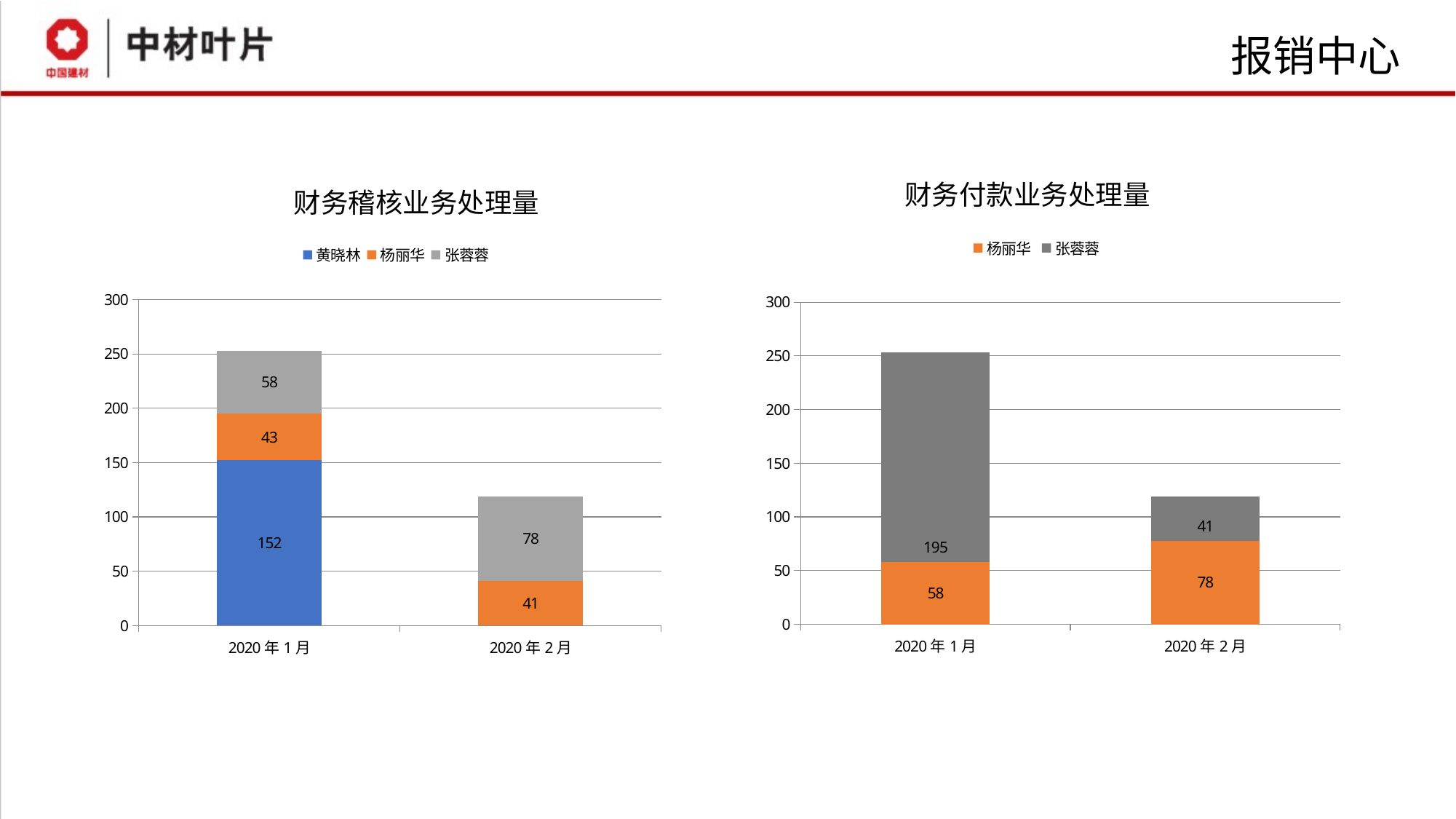
In the 财务付款业务处理量 chart, what is the total of the stacked bar for 2020 年 2 月? 119 In the 财务稽核业务处理量 chart, how many series does the legend list? 3 In the 财务稽核业务处理量 chart, how many categories are shown on the x axis? 2 In the 财务稽核业务处理量 chart, what is the value for 张蓉蓉 in 2020 年 2 月? 78 In the 财务付款业务处理量 chart, which is larger in 2020 年 1 月, 杨丽华 or 张蓉蓉? 张蓉蓉 In the 财务稽核业务处理量 chart, what is the value for 黄晓林 in 2020 年 1 月? 152 In the 财务稽核业务处理量 chart, what is the difference between 张蓉蓉's values in 2020 年 2 月 and 2020 年 1 月? 20 In the 财务付款业务处理量 chart, how many series does the legend list? 2 What kind of chart is the 财务付款业务处理量 chart? Stacked bar chart In the 财务付款业务处理量 chart, what is the value for 杨丽华 in 2020 年 2 月? 78 In the 财务稽核业务处理量 chart, what is the total of the stacked bar for 2020 年 1 月? 253 In the 财务付款业务处理量 chart, what is the value for 张蓉蓉 in 2020 年 1 月? 195